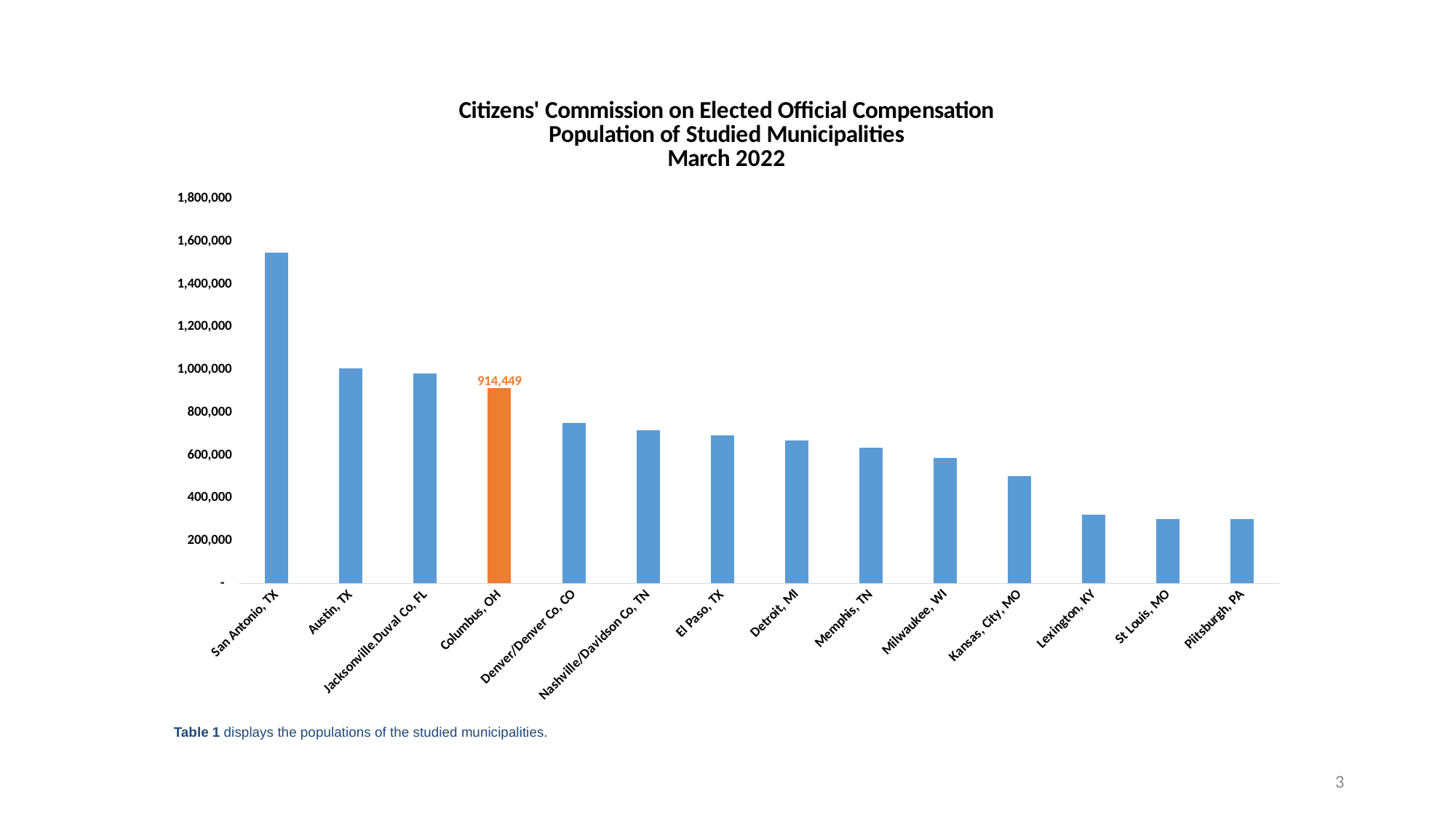
Is the value for Detroit, MI greater or less than 600,000? greater What is the population value labelled for Columbus, OH? 914,449 Which municipality has the highest population on the chart? San Antonio, TX How many municipalities are plotted on the chart? 14 Is the value for Pittsburgh, PA greater or less than 400,000? less Is the value for San Antonio, TX greater or less than 1,400,000? greater Which has the larger population, Memphis, TN or Milwaukee, WI? Memphis, TN What kind of chart is shown on the slide? Bar chart Which municipality's bar is highlighted in orange? Columbus, OH Do the population values rise or fall moving from left to right along the x axis? Fall Which has the larger population, Austin, TX or Columbus, OH? Austin, TX